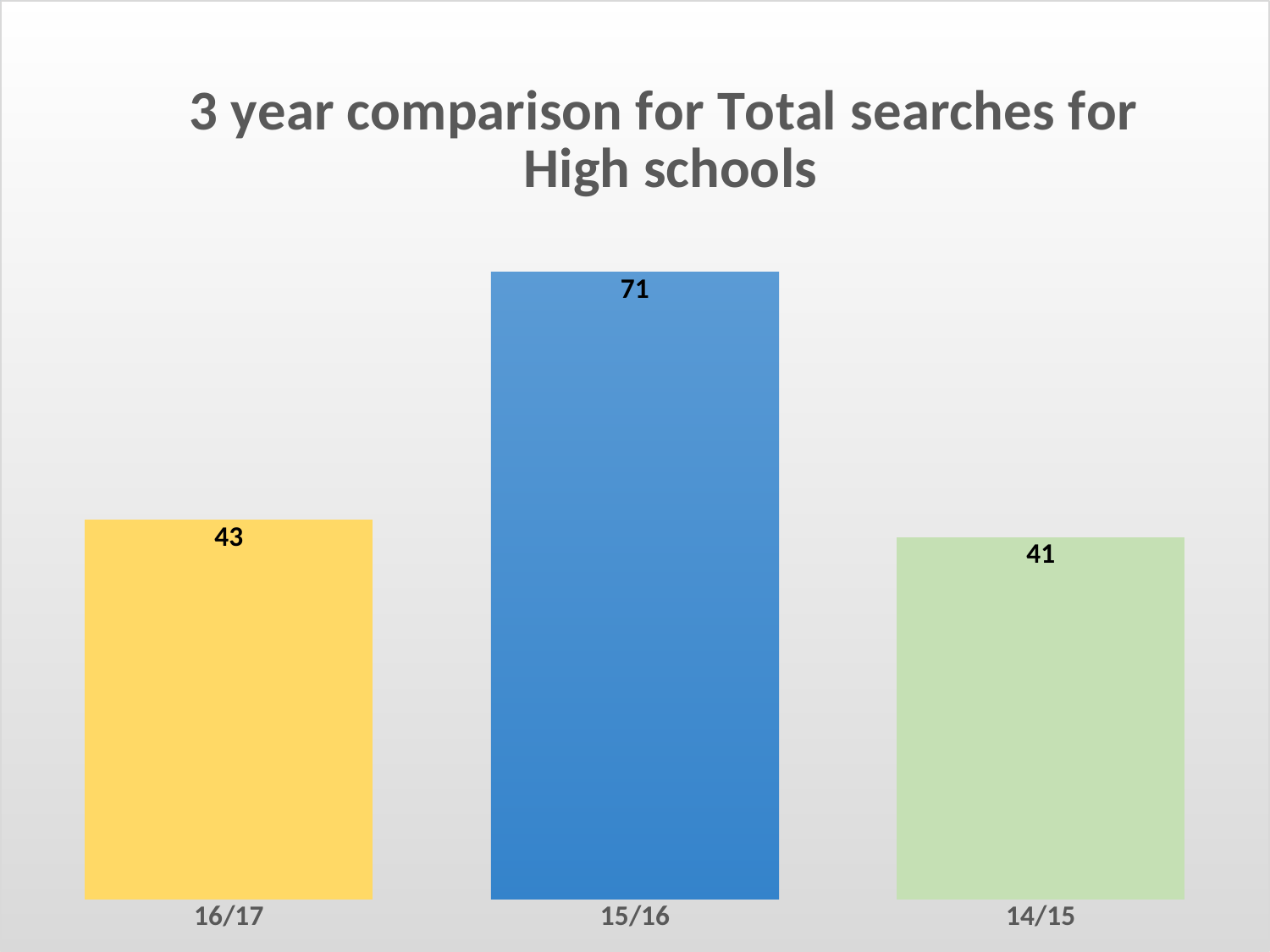
Which year has the highest value? 15/16 What is the title of the chart? 3 year comparison for Total searches for High schools What is the difference between the values for 15/16 and 16/17? 28 What is the value for 14/15? 41 What is the difference between the values for 16/17 and 14/15? 2 What kind of chart is this? Bar chart How many categories are shown in the chart? 3 Which year has the lowest value? 14/15 What is the value for 15/16? 71 What is the value for 16/17? 43 What colour is the bar for 15/16? Blue Which is larger, the value for 15/16 or the value for 14/15? 15/16